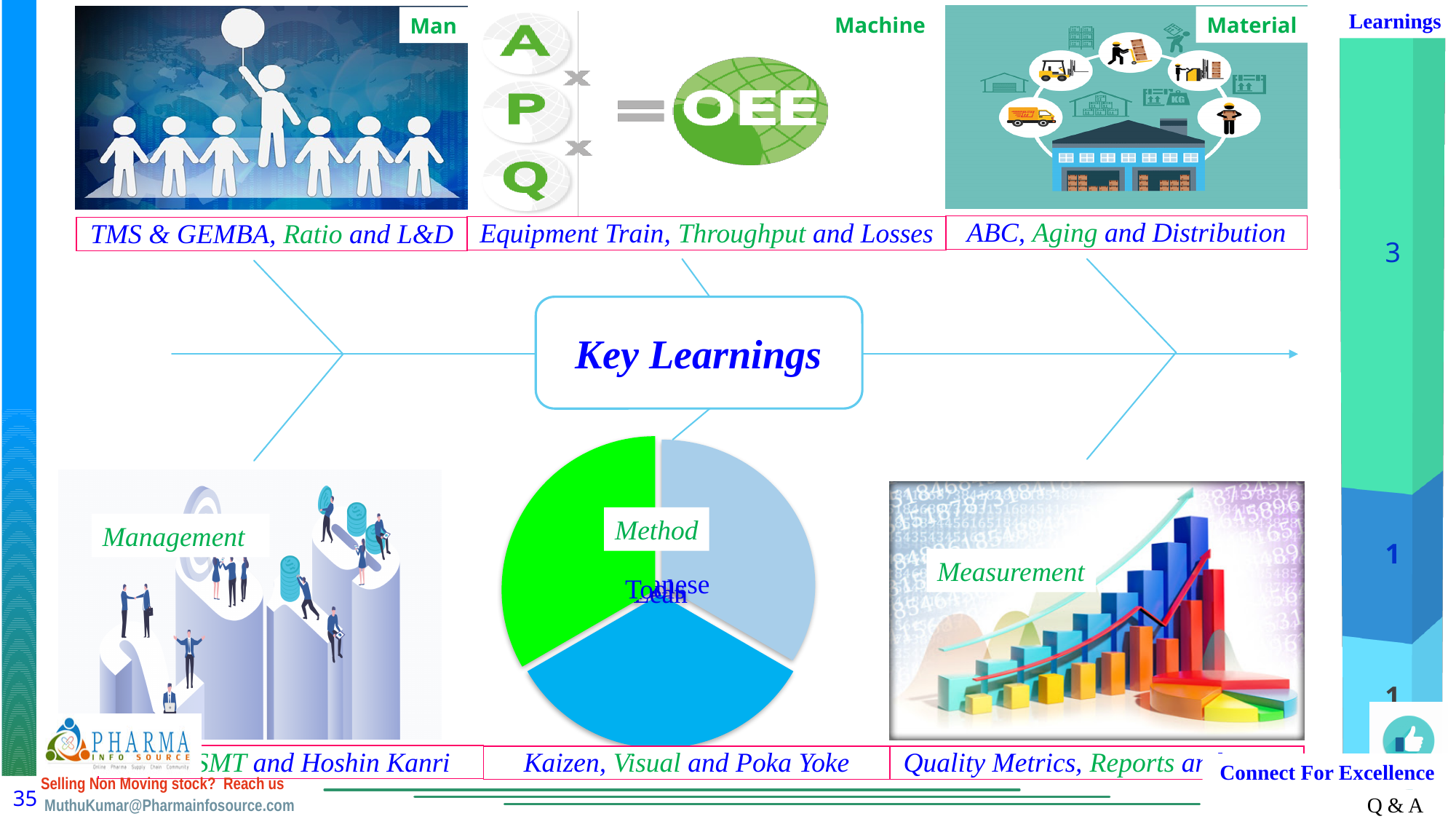
What kind of chart is the 'Learnings' chart on the right edge of the slide? bar chart What colours are the three slices of the pie chart in the centre of the slide? green, light blue and blue How many slices does the pie chart in the centre of the slide have? 3 What is the title of the stacked bar chart on the right edge of the slide? Learnings In the 'Learnings' stacked bar on the right, what is the value of the middle (blue) segment? 1 What is the total of all segments in the 'Learnings' stacked bar on the right? 5 In the 'Learnings' stacked bar on the right, what is the difference between the top segment and the middle segment? 2 In the 'Learnings' stacked bar on the right, what is the value of the top (green) segment? 3 What kind of chart is shown in the centre of the slide under the 'Method' label? pie chart In the 'Learnings' stacked bar on the right, is the top segment larger or smaller than the middle segment? larger How many segments make up the 'Learnings' stacked bar on the right? 3 In the 'Learnings' stacked bar on the right, which segment has the largest value? the top (green) segment, 3